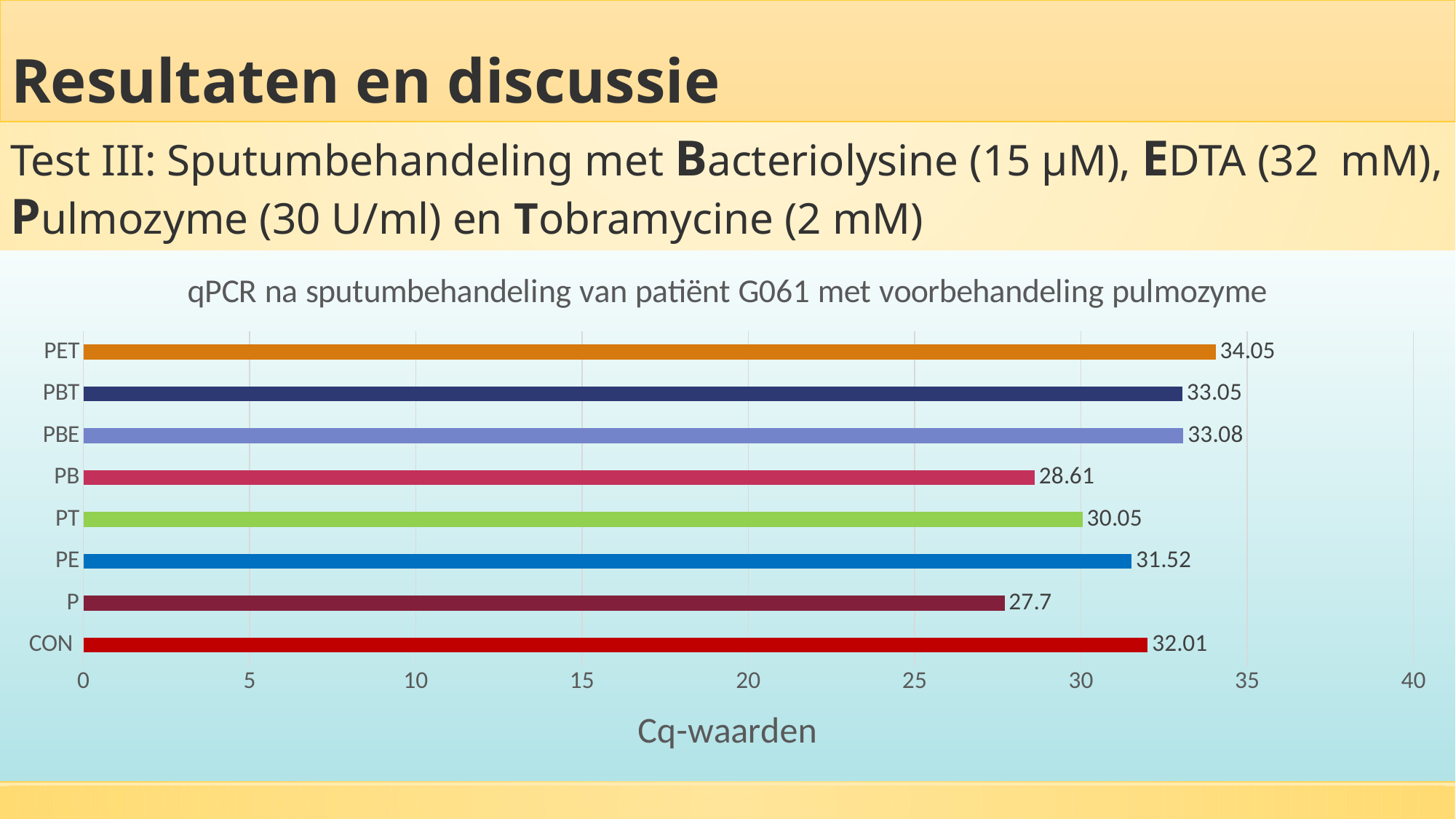
Which category has the lowest Cq value? P What is the difference between the Cq values of PE and PT? 1.47 Is the Cq value for PB greater or less than 30? less What kind of chart is shown on the slide? bar chart What is the difference between the Cq values of PET and P? 6.35 Which has a larger Cq value, PE or PT? PE What is the label of the horizontal axis? Cq-waarden What is the Cq value for PET? 34.05 What is the Cq value for CON? 32.01 Which category has the highest Cq value? PET How many categories are shown in the chart? 8 What is the Cq value for PB? 28.61